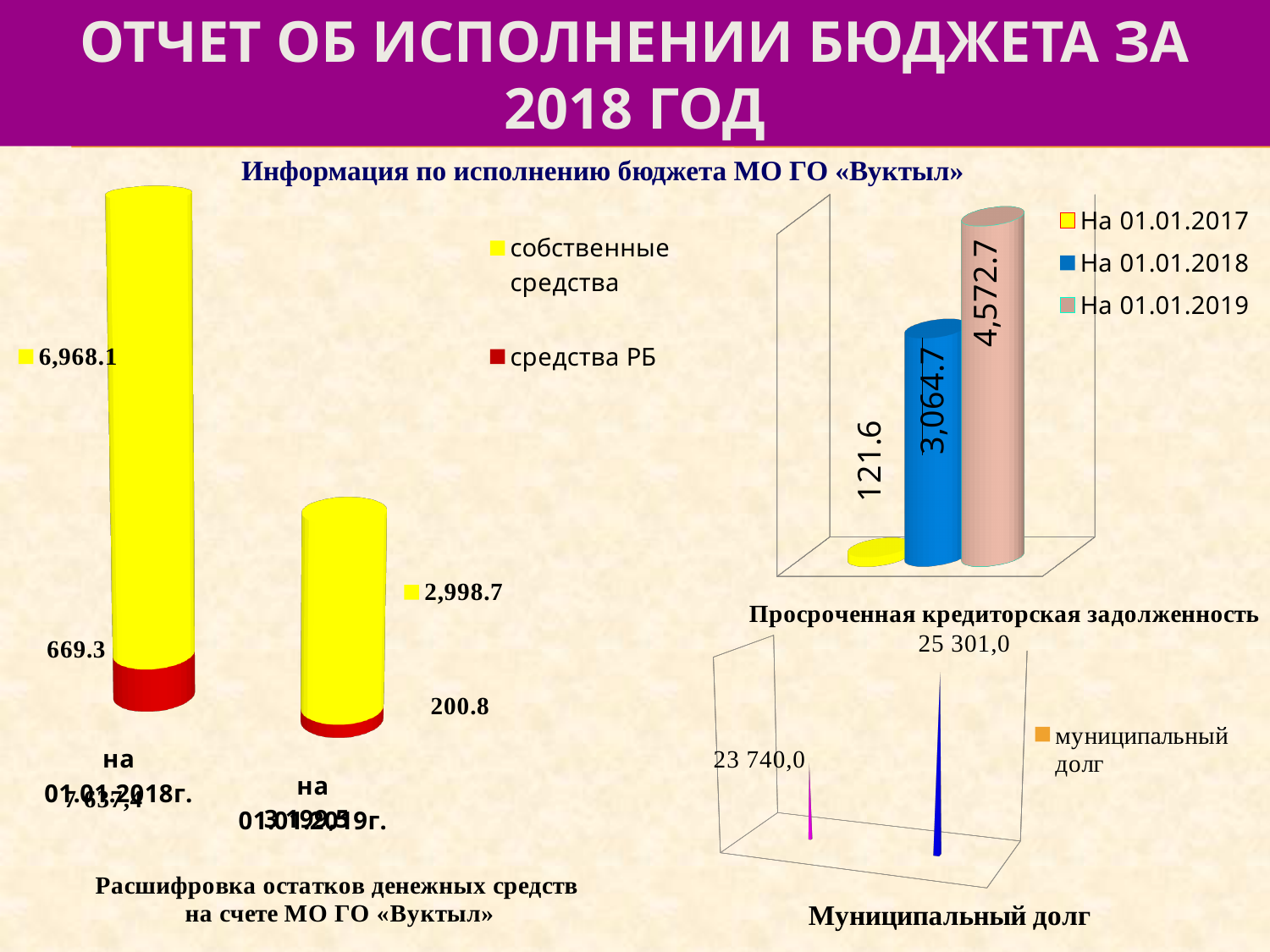
In the chart titled «Просроченная кредиторская задолженность», which date has the highest value? На 01.01.2019 In the chart titled «Расшифровка остатков денежных средств на счете МО ГО «Вуктыл»», what is the value of «собственные средства» for «на 01.01.2018г.»? 6,968.1 In the chart titled «Просроченная кредиторская задолженность», what is the value for «На 01.01.2018»? 3,064.7 In the chart titled «Муниципальный долг», which of the two plotted values is larger: 23 740,0 or 25 301,0? 25 301,0 In the chart titled «Расшифровка остатков денежных средств на счете МО ГО «Вуктыл»», how many series does the legend list? 2 In the chart titled «Просроченная кредиторская задолженность», what is the difference between the values for «На 01.01.2019» and «На 01.01.2018»? 1,508.0 In the chart titled «Расшифровка остатков денежных средств на счете МО ГО «Вуктыл»», what is the total of the stacked bar for «на 01.01.2018г.»? 7,637.4 In the chart titled «Расшифровка остатков денежных средств на счете МО ГО «Вуктыл»», by how much did «собственные средства» decrease from 01.01.2018 to 01.01.2019? 3,969.4 In the chart titled «Просроченная кредиторская задолженность», which date has the lowest value? На 01.01.2017 In the chart titled «Расшифровка остатков денежных средств на счете МО ГО «Вуктыл»», what is the value of «средства РБ» for «на 01.01.2019г.»? 200.8 In the chart titled «Просроченная кредиторская задолженность», do the values rise or fall from 01.01.2017 to 01.01.2019? rise In the chart titled «Расшифровка остатков денежных средств на счете МО ГО «Вуктыл»», which series is shown in red? средства РБ